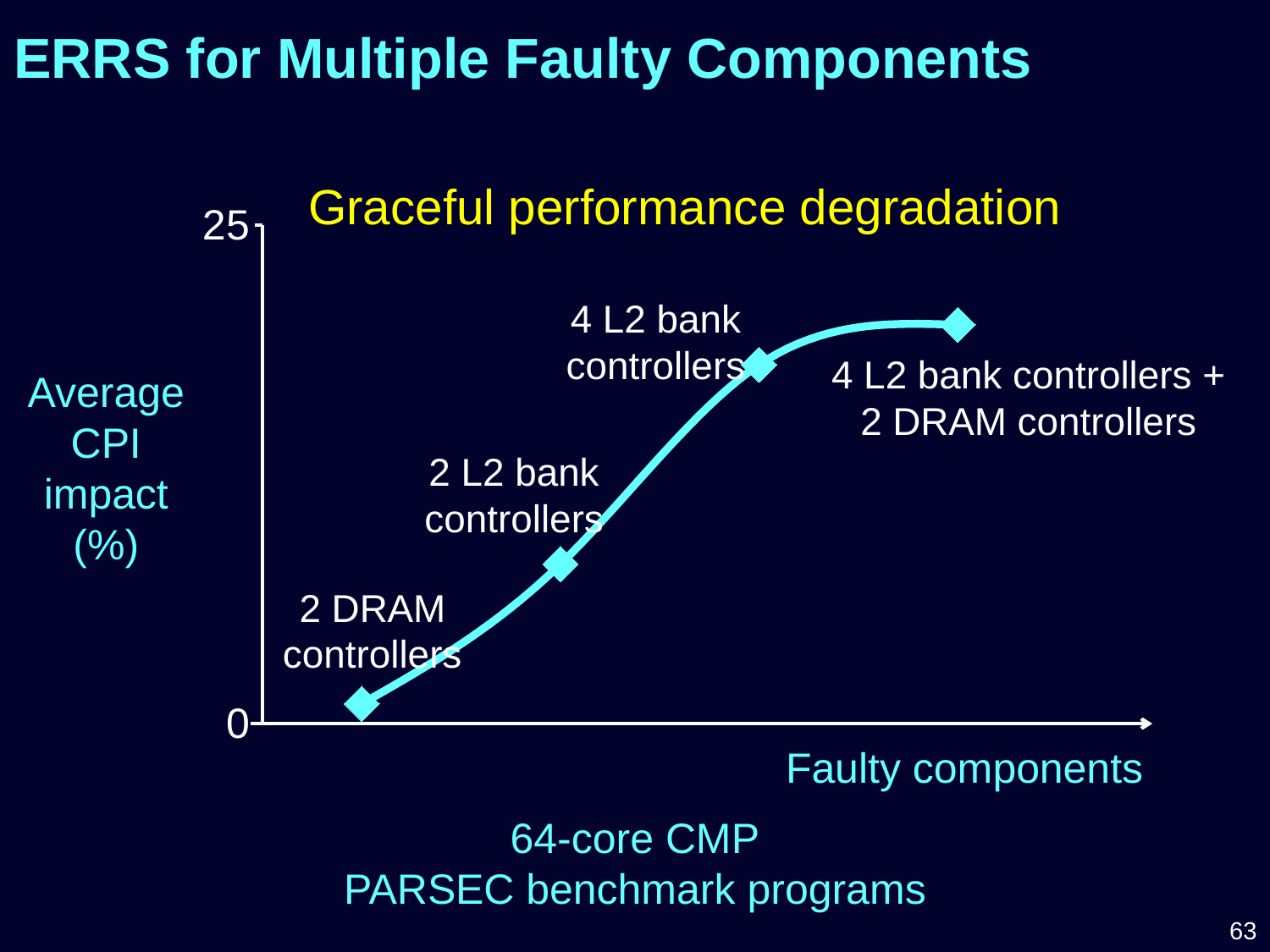
Which has a larger average CPI impact: 2 DRAM controllers or 2 L2 bank controllers? 2 L2 bank controllers Which faulty-component configuration has the lowest average CPI impact? 2 DRAM controllers Which has a larger average CPI impact: 2 L2 bank controllers or 4 L2 bank controllers? 4 L2 bank controllers What is the label of the y axis? Average CPI impact (%) Does the average CPI impact rise or fall as more faulty components are added along the x axis? rise Is the average CPI impact for 4 L2 bank controllers greater or less than 25? less What is the label of the x axis? Faulty components Which faulty-component configuration has the highest average CPI impact? 4 L2 bank controllers + 2 DRAM controllers What kind of chart is shown on the slide? line chart How many data points are plotted on the chart? 4 Is the average CPI impact for 4 L2 bank controllers + 2 DRAM controllers greater or less than 25? less